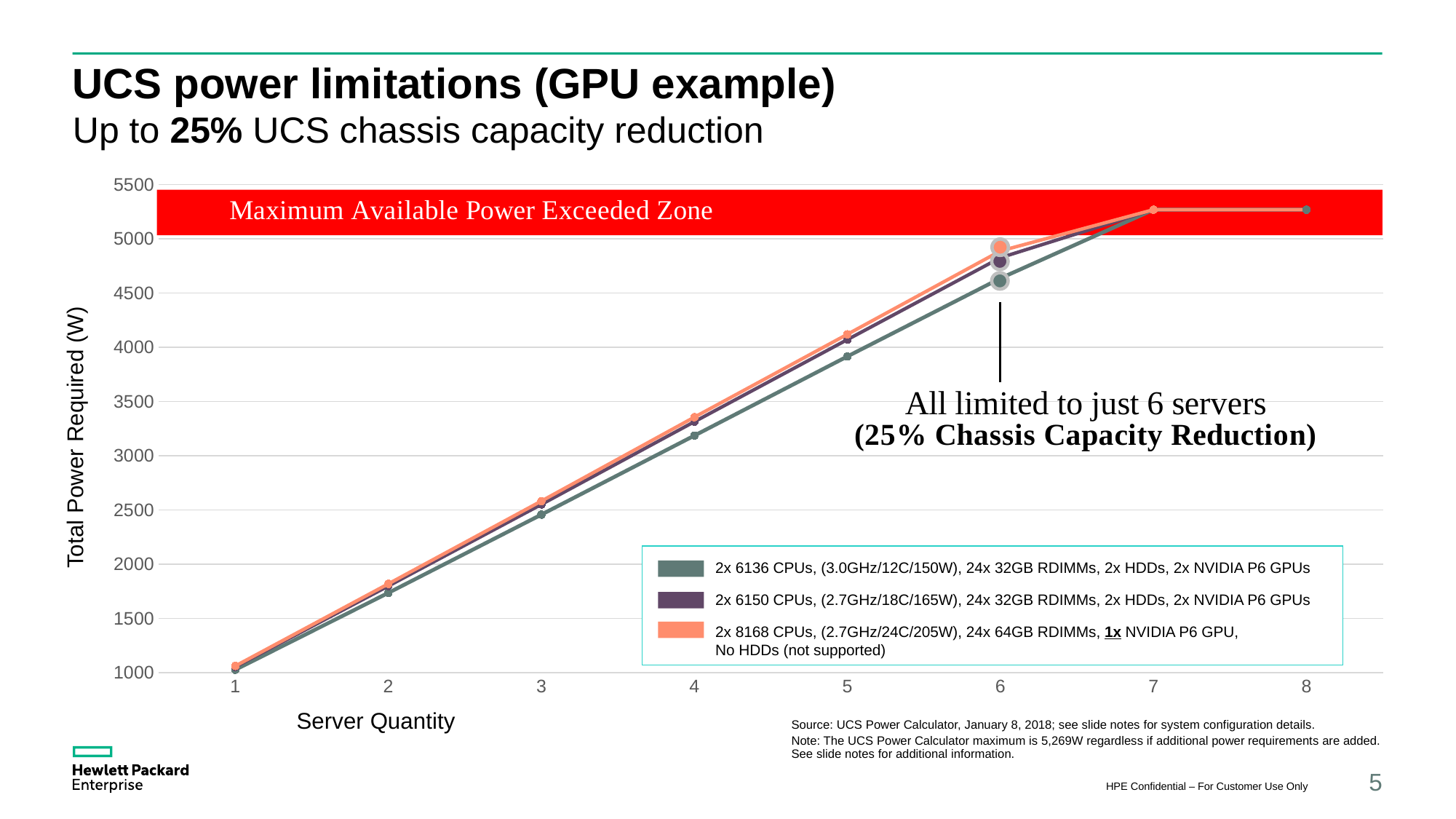
Is the value for the 2x 6136 CPUs series at 2 servers greater or less than 2000? less How many server quantity values are plotted along the x axis? 8 At 6 servers, which requires more power: the 2x 6136 CPUs series or the 2x 8168 CPUs series? 2x 8168 CPUs series What text is written in the red band at the top of the chart? Maximum Available Power Exceeded Zone How many series does the chart legend list? 3 At 6 servers, which series has the lowest total power required? 2x 6136 CPUs, (3.0GHz/12C/150W), 24x 32GB RDIMMs, 2x HDDs, 2x NVIDIA P6 GPUs What kind of chart is shown on the slide? line chart Is the value for the 2x 8168 CPUs series at 6 servers greater or less than 4500? greater What is the label of the y axis? Total Power Required (W) At 6 servers, which series has the highest total power required? 2x 8168 CPUs, (2.7GHz/24C/205W), 24x 64GB RDIMMs, 1x NVIDIA P6 GPU, No HDDs (not supported) Do the plotted power values rise or fall as the server quantity increases from 1 to 6? rise Is the value for the 2x 6136 CPUs series at 6 servers greater or less than 5000? less